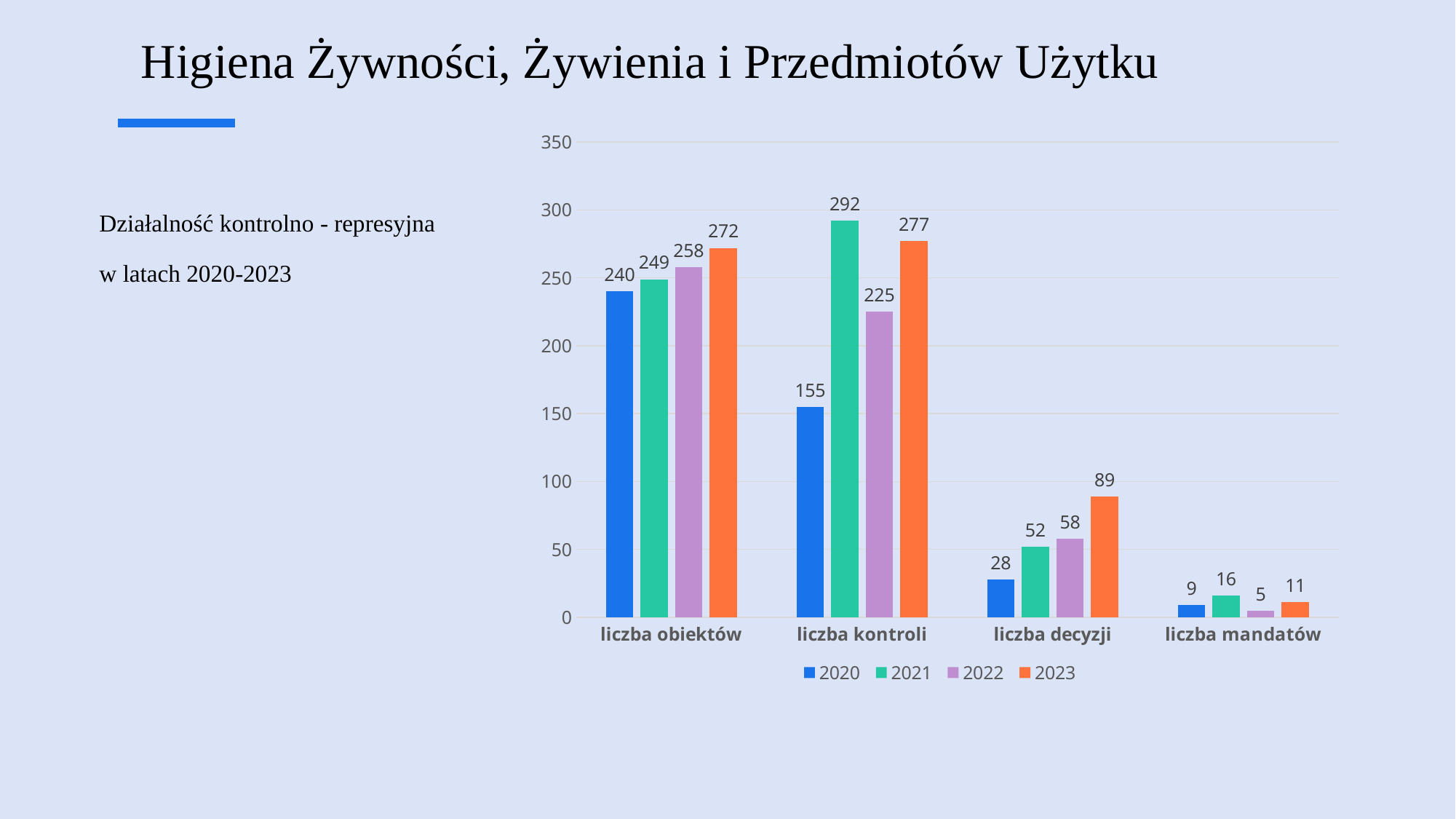
What is the value for 2022 in the liczba mandatów category? 5 What is the value for 2020 in the liczba obiektów category? 240 Which year has the lowest value in the liczba kontroli category? 2020 Which year has the highest value in the liczba decyzji category? 2023 Which colour represents the year 2023 in the chart? orange What kind of chart is shown on the slide? bar chart How many series does the legend list? 4 Is the value for 2021 in the liczba obiektów category greater or less than 200? greater How many categories are shown on the x axis? 4 Which is larger: the 2022 value for liczba obiektów or the 2022 value for liczba kontroli? liczba obiektów What is the value for 2021 in the liczba kontroli category? 292 What is the difference between the 2023 and 2020 values in the liczba kontroli category? 122